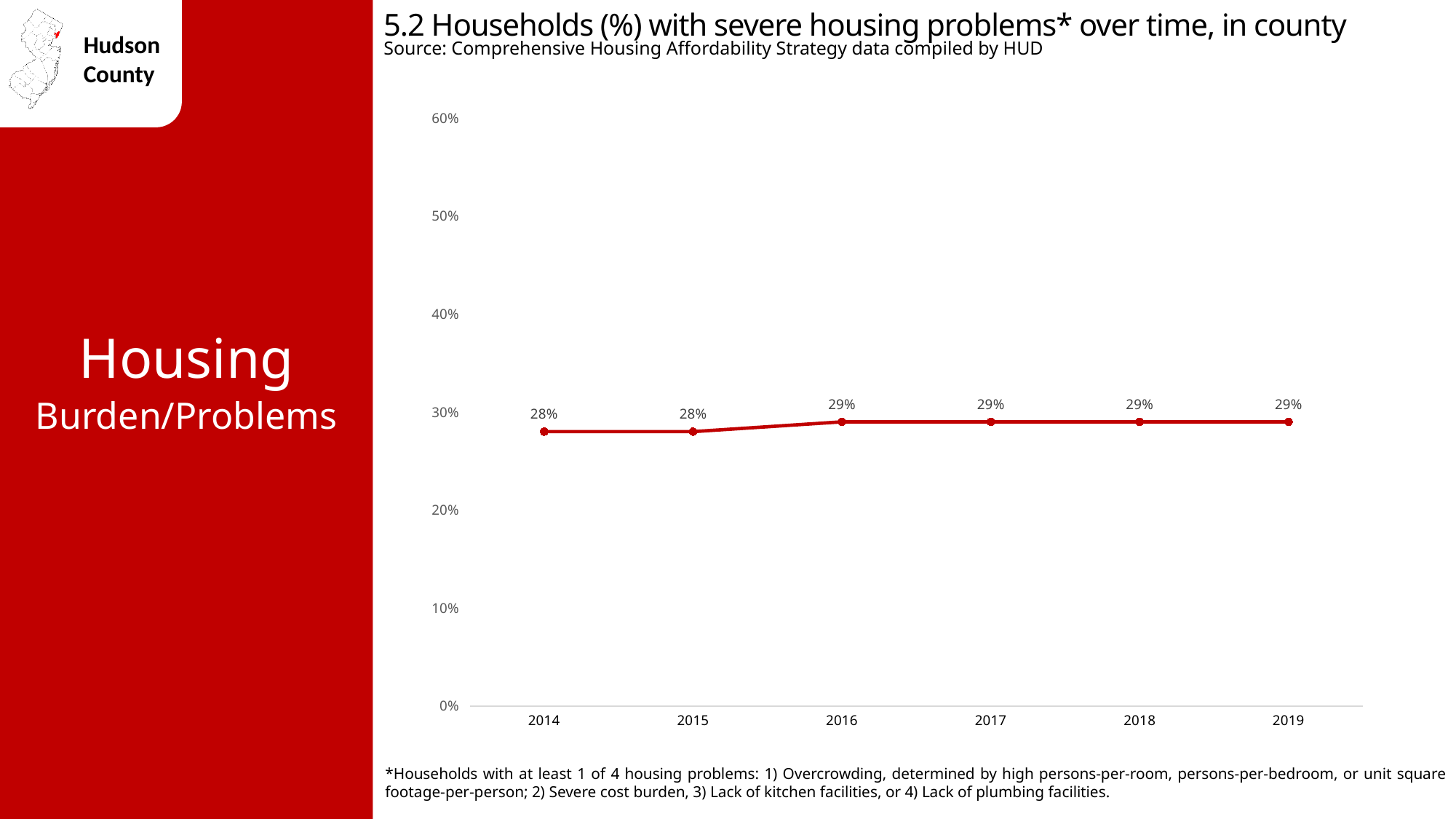
How many years are plotted on the chart? 6 What is the source of the data shown in the chart? Comprehensive Housing Affordability Strategy data compiled by HUD What is the value shown for 2015? 28% What percentage of households had severe housing problems in 2016? 29% What is the title of the chart? 5.2 Households (%) with severe housing problems* over time, in county What percentage of households had severe housing problems in 2014? 28% What percentage of households had severe housing problems in 2019? 29% What kind of chart is shown on the slide? line chart Is the value for 2018 greater or less than 20%? greater What is the difference between the 2019 value and the 2014 value? 1% Do the values rise or fall from 2014 to 2019? rise Is the value for 2017 greater or less than 40%? less